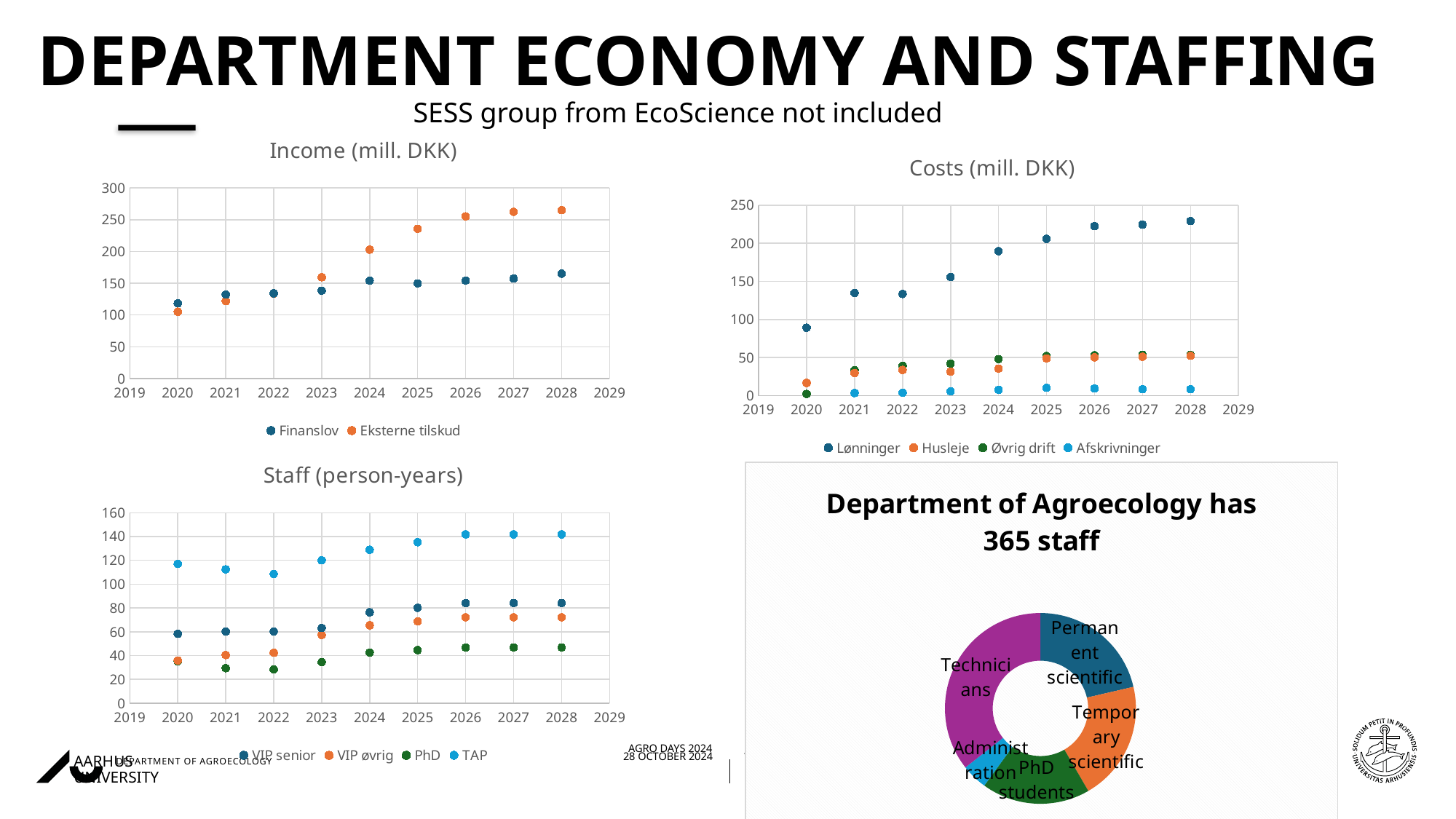
In the Costs (mill. DKK) chart, which series has the highest values? Lønninger In the Income (mill. DKK) chart, does Eksterne tilskud rise or fall from 2020 to 2028? rise What type of chart is the Income (mill. DKK) chart? scatter chart In the Costs (mill. DKK) chart, which series has the lowest values? Afskrivninger In the Staff (person-years) chart, which series has the highest values? TAP In the Income (mill. DKK) chart, is the value for Eksterne tilskud in 2028 greater or less than 250? greater In the Costs (mill. DKK) chart, is the value for Lønninger in 2020 greater or less than 100? less In the donut chart titled 'Department of Agroecology has 365 staff', which slice is the largest? Technicians How many years are plotted for each series in the Staff (person-years) chart? 9 In the Income (mill. DKK) chart, which series is larger in 2020, Finanslov or Eksterne tilskud? Finanslov How many series does the legend of the Costs (mill. DKK) chart list? 4 In the Staff (person-years) chart, is the value for PhD in 2021 greater or less than 40? less